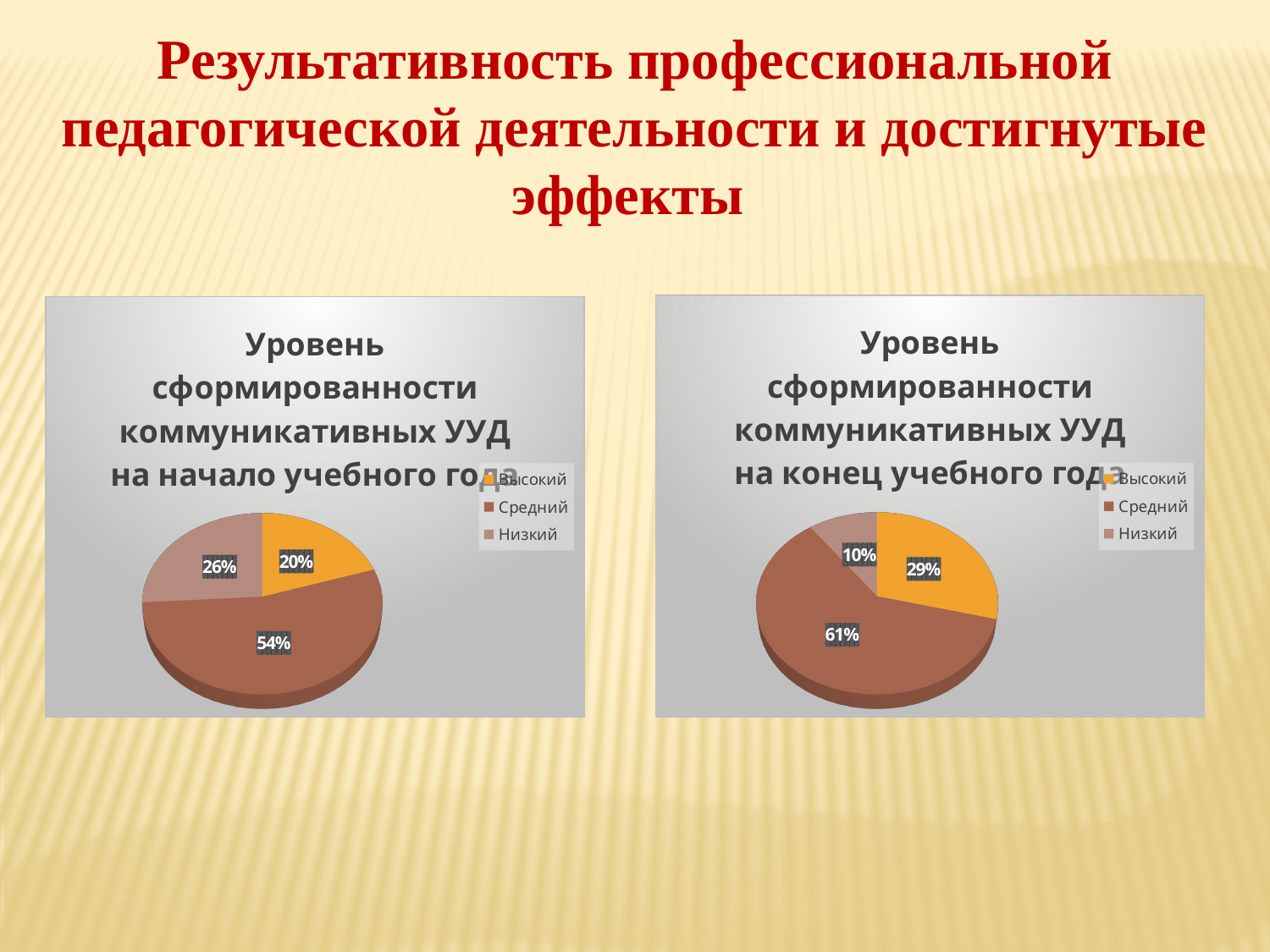
In the left chart (start of the school year), what is the share for Средний? 54% In the left chart (start of the school year), what is the share for Высокий? 20% In the left chart (start of the school year), what is the difference between the Средний and Низкий shares? 28% In the right chart (end of the school year), what is the share for Высокий? 29% In the left chart (start of the school year), which category has the smallest slice? Высокий In the left chart (start of the school year), what is the share for Низкий? 26% In the right chart (end of the school year), what is the share for Низкий? 10% In the right chart (end of the school year), what is the share for Средний? 61% How many entries does the legend of the right chart list? 3 What kind of chart is the left chart on the slide? pie chart Which is larger: the Высокий share in the left chart or the Высокий share in the right chart? the right chart (29%) In the right chart (end of the school year), which category has the largest slice? Средний